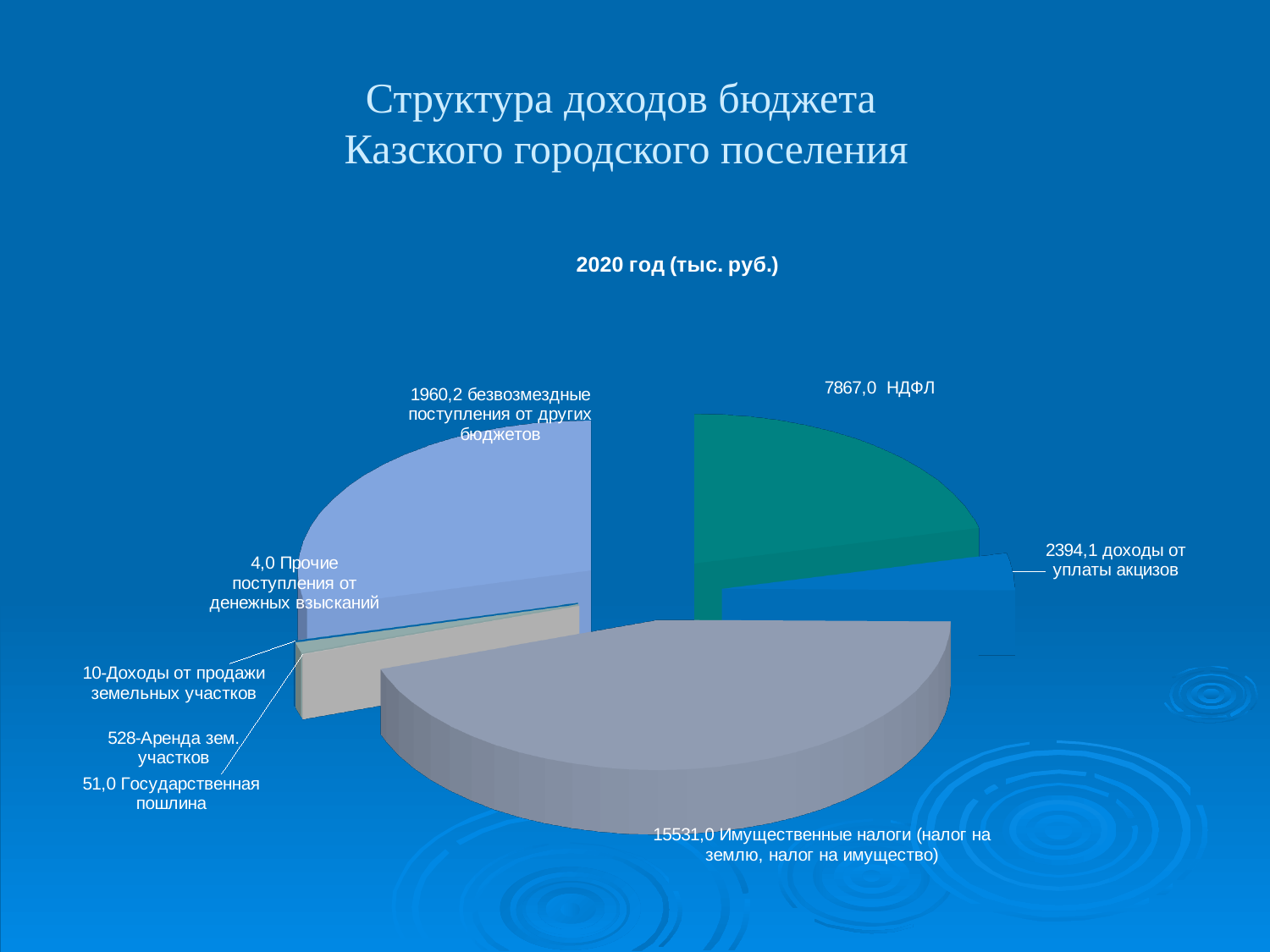
What is the difference between Имущественные налоги and НДФЛ? 7664,0 What type of chart is shown on the slide? pie chart What is the value for НДФЛ in the pie chart? 7867,0 Which category has the smallest value in the pie chart? Прочие поступления от денежных взысканий What is the value for Имущественные налоги (налог на землю, налог на имущество)? 15531,0 Which is larger: доходы от уплаты акцизов or безвозмездные поступления от других бюджетов? доходы от уплаты акцизов What is the value for доходы от уплаты акцизов? 2394,1 Which category has the largest value in the pie chart? Имущественные налоги (налог на землю, налог на имущество) How many categories (slices) does the pie chart have? 8 What is the title of the pie chart? 2020 год (тыс. руб.) What is the value for Аренда зем. участков? 528 What is the value for безвозмездные поступления от других бюджетов? 1960,2